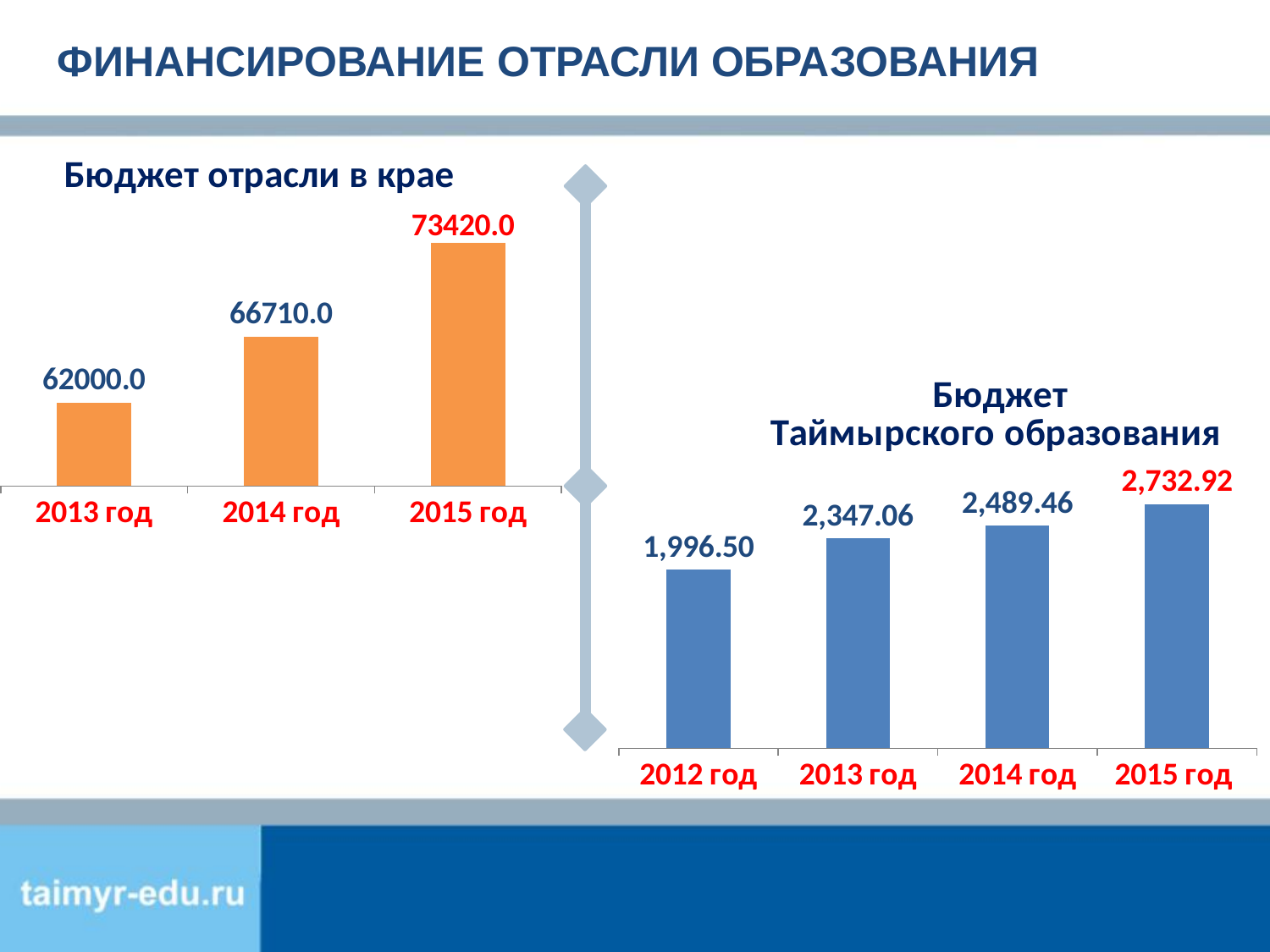
In the chart "Бюджет отрасли в крае", do the values rise or fall from 2013 год to 2015 год? rise In the chart "Бюджет отрасли в крае", how many years are shown? 3 In the chart "Бюджет отрасли в крае", which year has the highest value? 2015 год In the chart "Бюджет отрасли в крае", what is the value for 2014 год? 66710.0 In the chart "Бюджет Таймырского образования", how many years are shown? 4 In the chart "Бюджет Таймырского образования", what is the value for 2012 год? 1,996.50 In the chart "Бюджет отрасли в крае", what is the difference between the values for 2015 год and 2013 год? 11420.0 In the chart "Бюджет Таймырского образования", which year has the lowest value? 2012 год In the chart "Бюджет Таймырского образования", which is larger, the value for 2013 год or 2014 год? 2014 год In the chart "Бюджет Таймырского образования", what is the difference between the values for 2015 год and 2012 год? 736.42 In the chart "Бюджет Таймырского образования", what is the value for 2014 год? 2,489.46 What type of chart is "Бюджет Таймырского образования"? bar chart